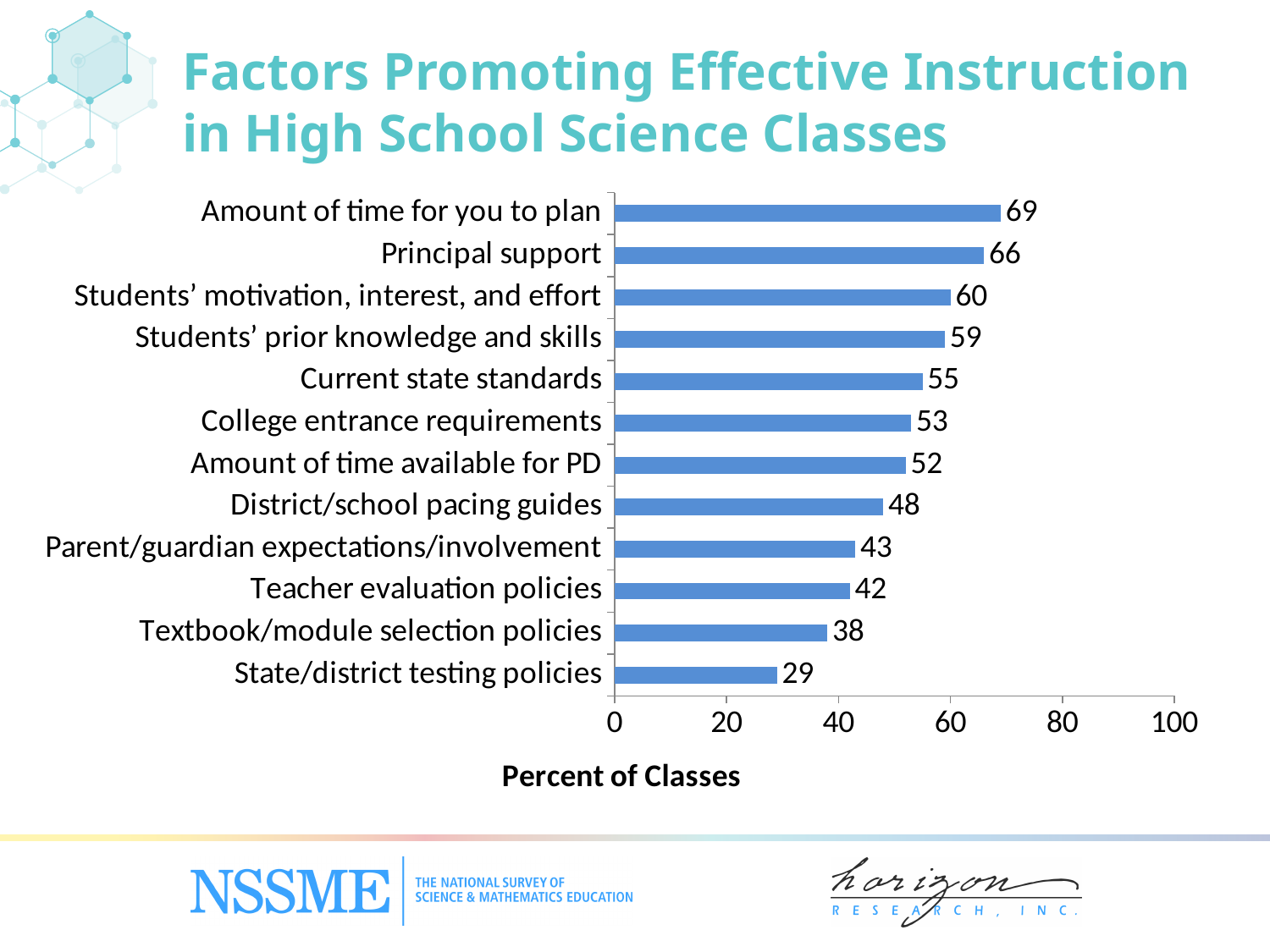
Which factor has the lowest value? State/district testing policies What is the difference between the values for Amount of time for you to plan and State/district testing policies? 40 Which factor has the highest value? Amount of time for you to plan What is the label of the horizontal axis? Percent of Classes What is the value for District/school pacing guides? 48 What is the difference between the values for Current state standards and College entrance requirements? 2 How many factors are shown in the chart? 12 What is the value for Principal support? 66 What is the value for Textbook/module selection policies? 38 Which is larger, the value for Teacher evaluation policies or the value for Amount of time available for PD? Amount of time available for PD What kind of chart is shown on the slide? bar chart Is the value for Parent/guardian expectations/involvement greater or less than 40? greater